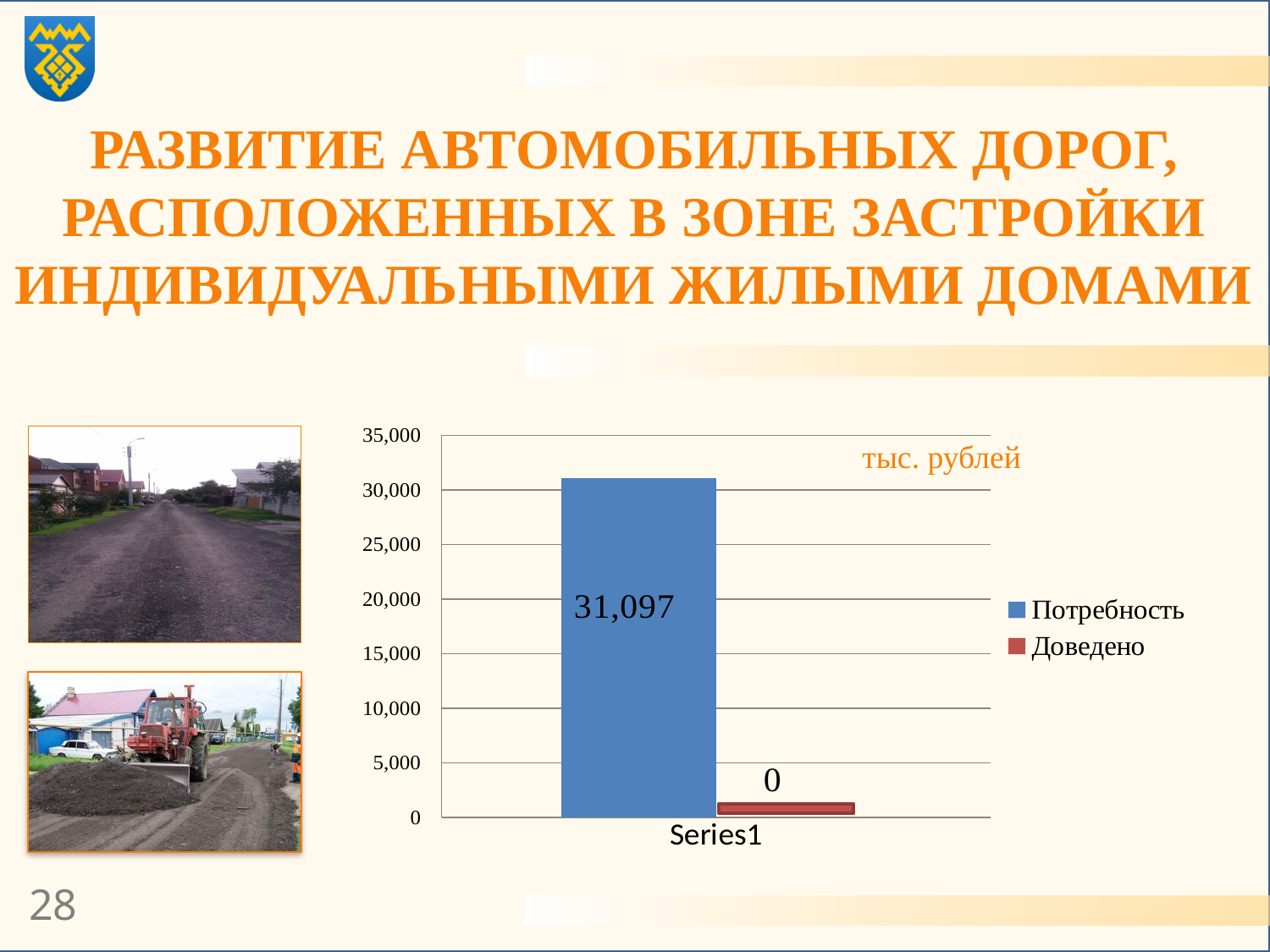
What colour is the bar for Потребность? blue Which series has the higher value, Потребность or Доведено? Потребность What is the difference between the Потребность and Доведено values? 31,097 What is the category label shown on the x axis of the chart? Series1 What unit is indicated in the top right corner of the chart? тыс. рублей Is the value for Потребность greater or less than 30,000? greater Which series has the lowest value on the chart? Доведено Is the value for Потребность greater or less than 35,000? less What is the value of Потребность shown on the chart? 31,097 What is the value of Доведено shown on the chart? 0 What kind of chart is shown on the slide? bar chart How many series does the legend list? 2